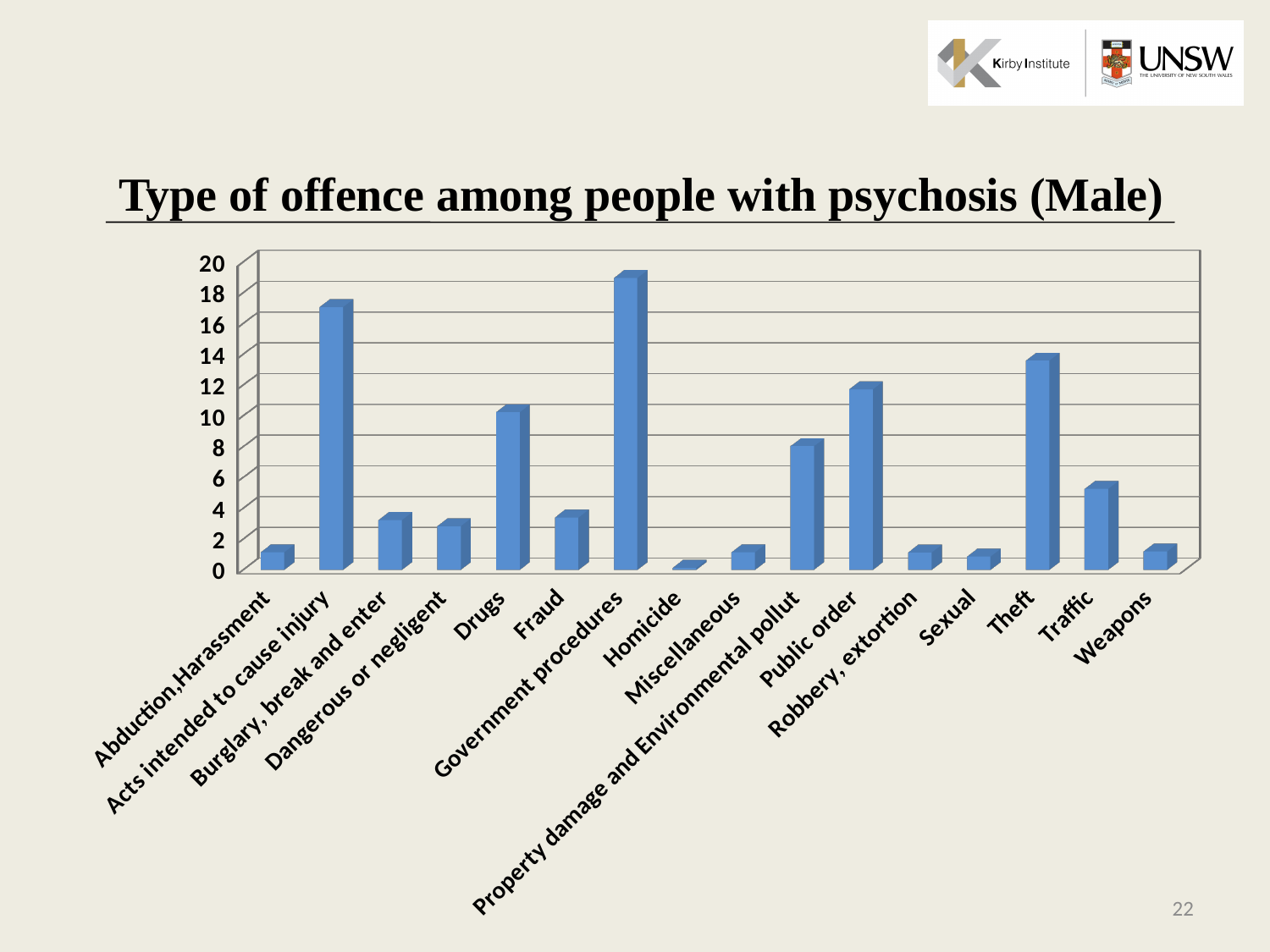
Which is larger, the value for Acts intended to cause injury or the value for Drugs? Acts intended to cause injury How many offence categories are shown on the x axis? 16 Is the value for Acts intended to cause injury greater or less than 14? greater What kind of chart is shown on the slide? bar chart Which offence type has the highest value? Government procedures Is the value for Public order greater or less than 10? greater What is the title of the chart? Type of offence among people with psychosis (Male) Is the value for Traffic greater or less than 8? less Which offence type has the lowest value? Homicide Which is larger, the value for Theft or the value for Traffic? Theft